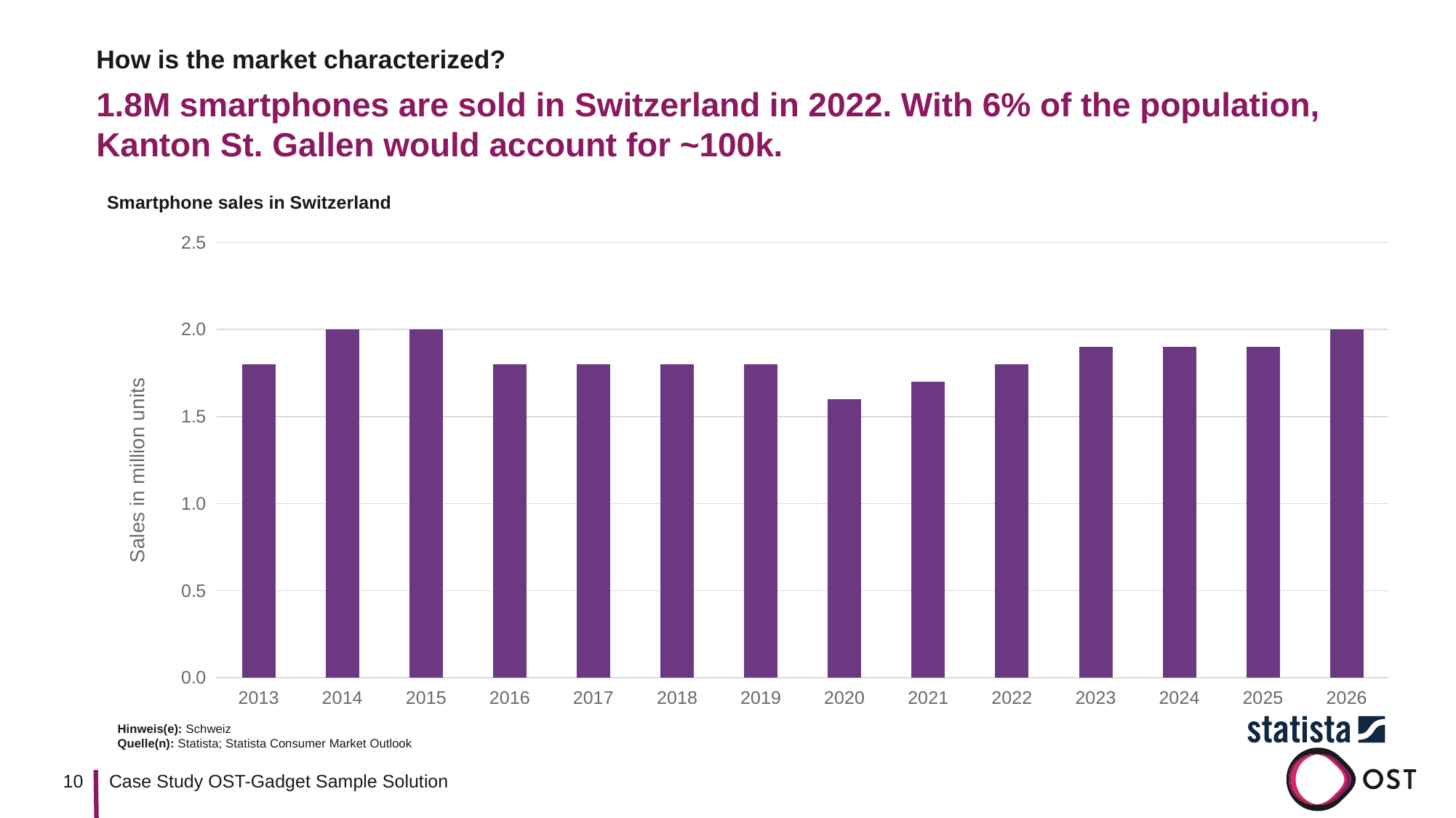
What is the title of the chart? Smartphone sales in Switzerland What is the label of the vertical axis? Sales in million units What is the value for 2026 in the chart? 2.0 Which is larger, the value for 2015 or the value for 2020? 2015 Which year has the lowest smartphone sales in the chart? 2020 What is the value for 2014 in the chart? 2.0 Is the value for 2013 greater or less than 1.5? greater Is the value for 2020 greater or less than 2.0? less Is the value for 2023 greater or less than 1.5? greater Do the values rise or fall from 2020 to 2026? rise How many years are shown on the x axis of the chart? 14 What type of chart is shown on the slide? bar chart